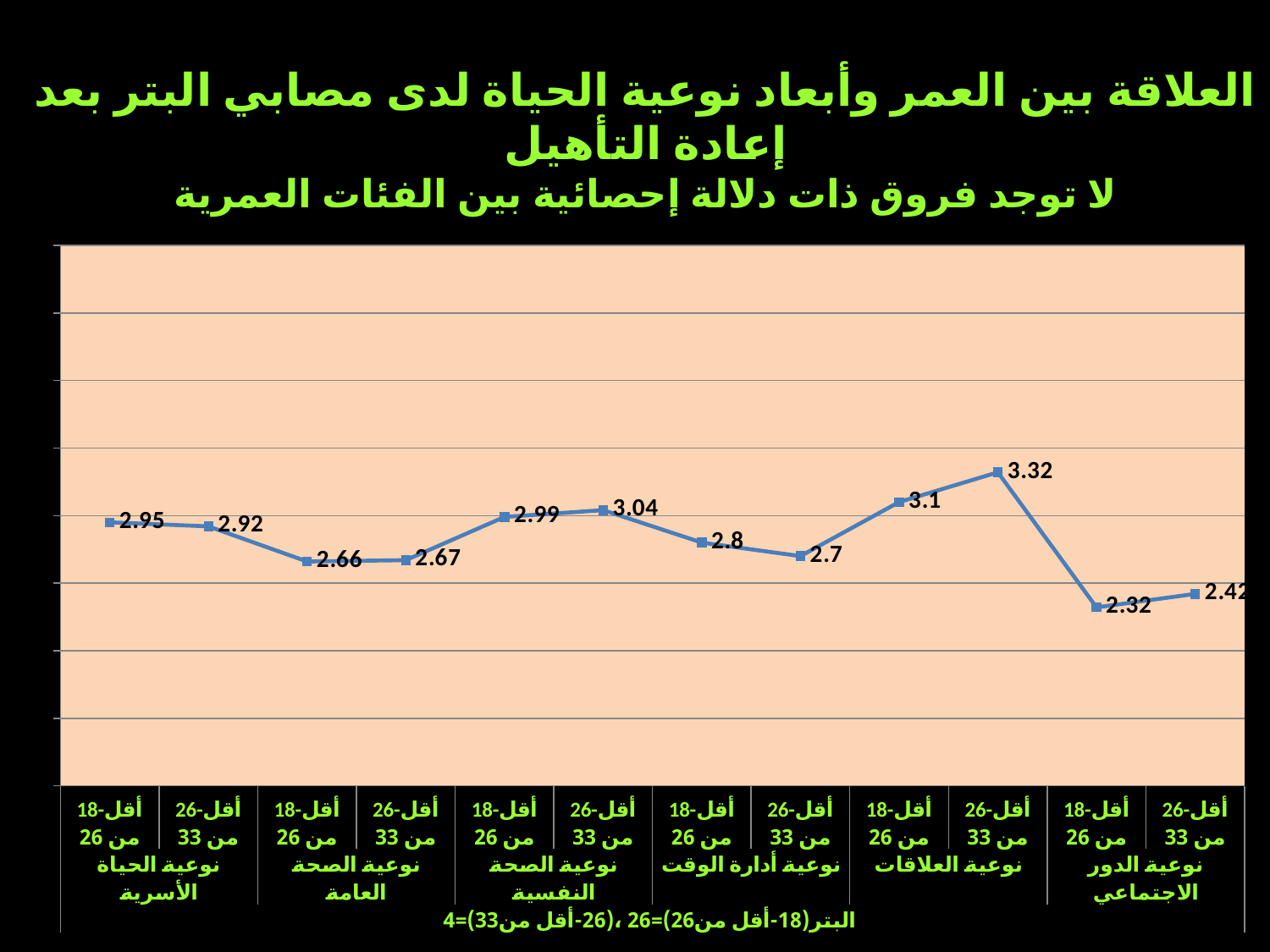
What is the value for the 18-less than 26 age group in نوعية الحياة الأسرية (family life quality)? 2.95 How many data points are plotted on the line? 12 What is the value for the 26-less than 33 age group in نوعية العلاقات (relationships quality)? 3.32 Which data point has the highest value on the chart? 26-less than 33 in نوعية العلاقات (3.32) What is the difference between the two age groups in نوعية الحياة الأسرية (2.95 and 2.92)? 0.03 Which age group has the larger value in نوعية أدارة الوقت (time management quality): 18-less than 26 or 26-less than 33? 18-less than 26 What is the value for the 18-less than 26 age group in نوعية الدور الاجتماعي (social role quality)? 2.32 What type of chart is shown on the slide? line chart What is the value for the 26-less than 33 age group in نوعية الصحة النفسية (psychological health quality)? 3.04 Within نوعية الدور الاجتماعي, does the value rise or fall from the 18-less than 26 group to the 26-less than 33 group? rise What is the difference between the two age groups in نوعية العلاقات (3.32 and 3.1)? 0.22 Which data point has the lowest value on the chart? 18-less than 26 in نوعية الدور الاجتماعي (2.32)